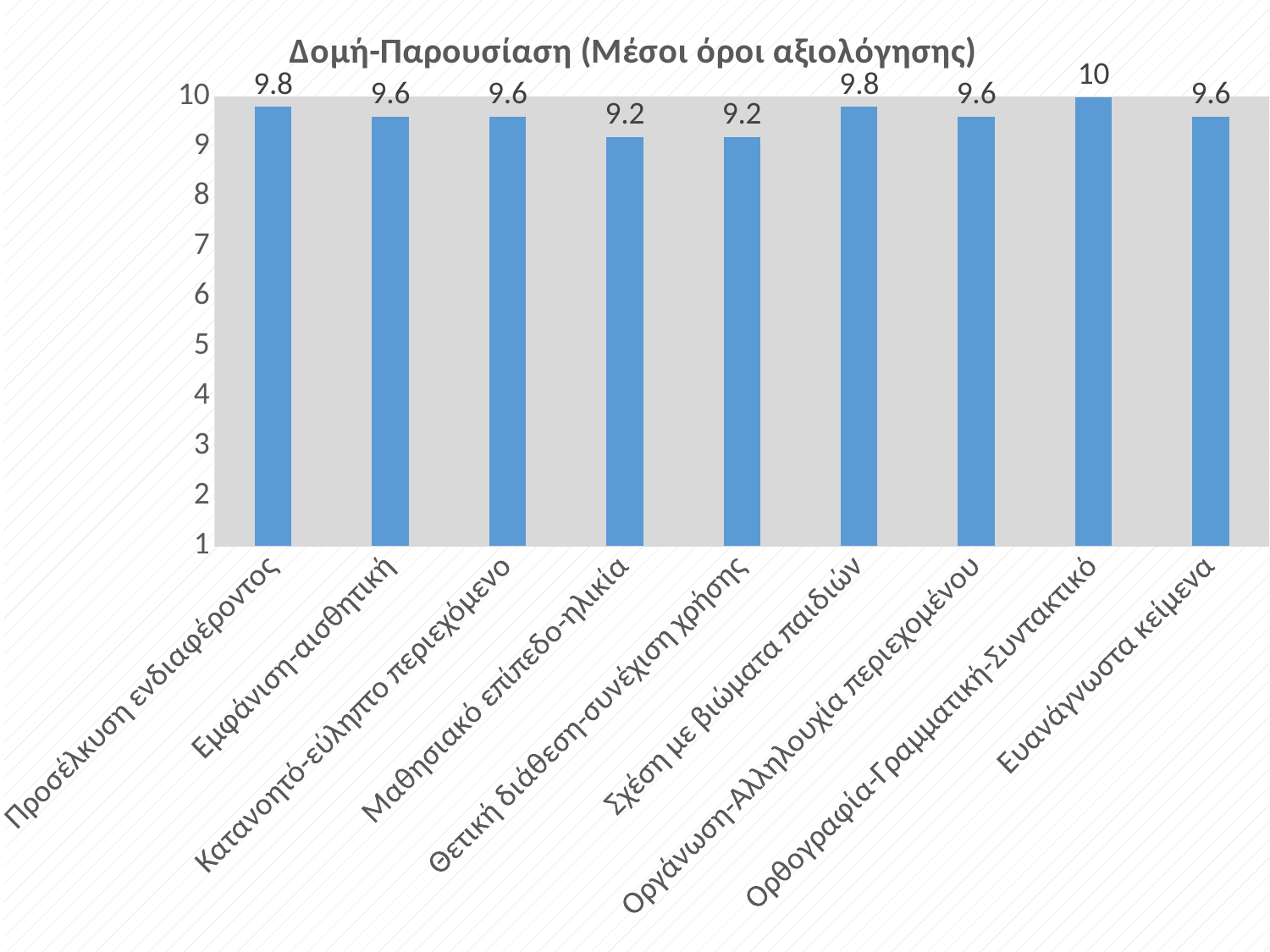
What is the value for Προσέλκυση ενδιαφέροντος? 9.8 What is the lowest value shown in the chart? 9.2 Is the value for Εμφάνιση-αισθητική greater or less than 9? greater What is the title of the chart? Δομή-Παρουσίαση (Μέσοι όροι αξιολόγησης) Which category has the highest value? Ορθογραφία-Γραμματική-Συντακτικό What is the value for Ορθογραφία-Γραμματική-Συντακτικό? 10 What kind of chart is shown on the slide? bar chart What is the value for Μαθησιακό επίπεδο-ηλικία? 9.2 Which is larger, the value for Σχέση με βιώματα παιδιών or the value for Οργάνωση-Αλληλουχία περιεχομένου? Σχέση με βιώματα παιδιών What is the difference between the values for Ορθογραφία-Γραμματική-Συντακτικό and Θετική διάθεση-συνέχιση χρήσης? 0.8 What is the value for Ευανάγνωστα κείμενα? 9.6 How many categories are shown in the chart? 9